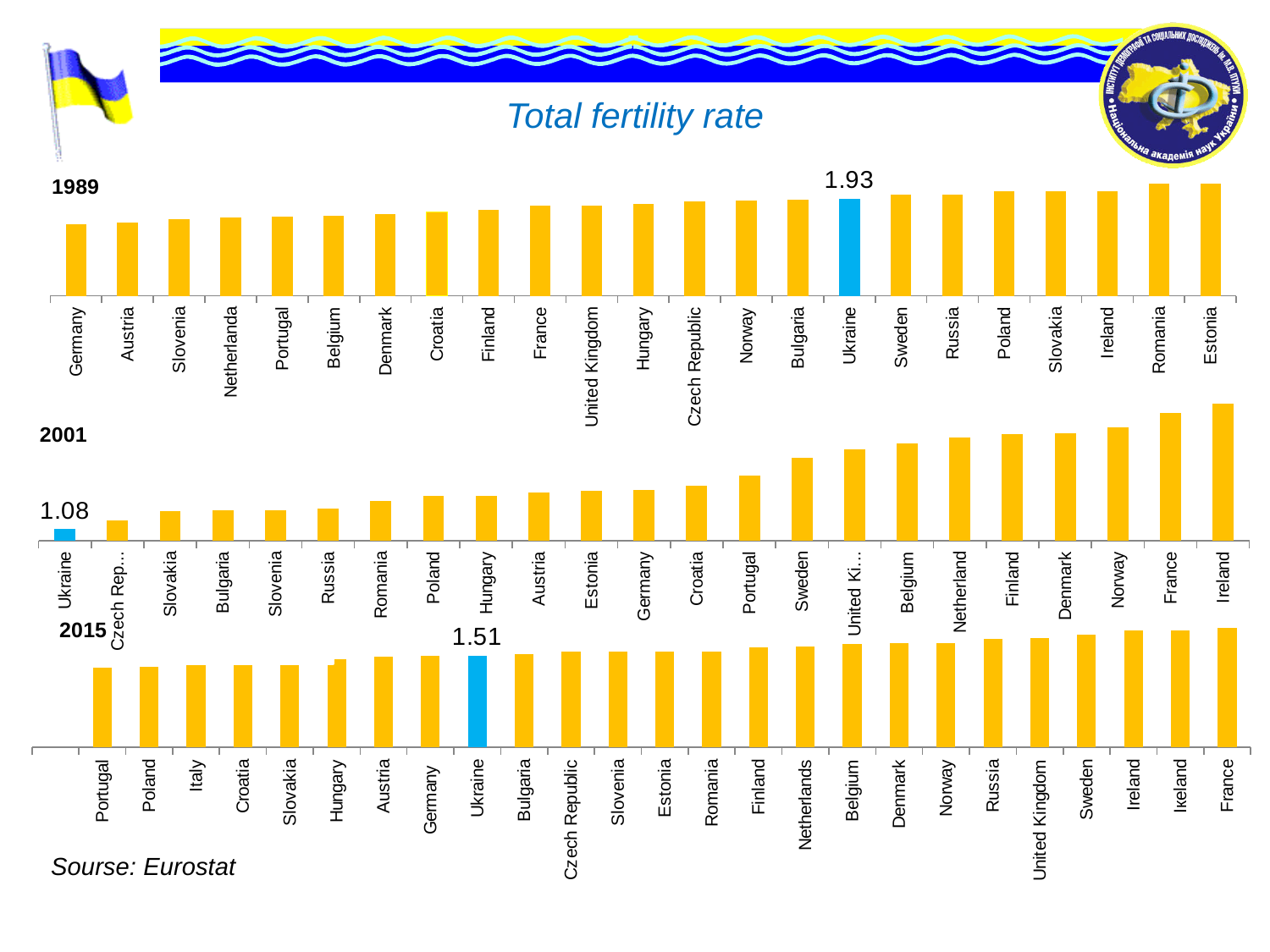
In the 2001 chart, do the values rise or fall from left to right along the x axis? rise What kind of chart is used for the 1989 data? bar chart In the 2001 chart, what is the total fertility rate shown for Ukraine? 1.08 In the 2015 chart, which is larger, the value for France or the value for Portugal? France In the 2001 chart, which country has the lowest total fertility rate? Ukraine In the 1989 chart, which is larger, the value for Ukraine or the value for Germany? Ukraine In the 2001 chart, which country has the highest total fertility rate? Ireland What is the title of the slide's charts? Total fertility rate In the 2015 chart, what is the total fertility rate shown for Ukraine? 1.51 In the 1989 chart, what is the total fertility rate shown for Ukraine? 1.93 How many countries are shown in the 1989 chart? 23 How many countries are shown in the 2015 chart? 25